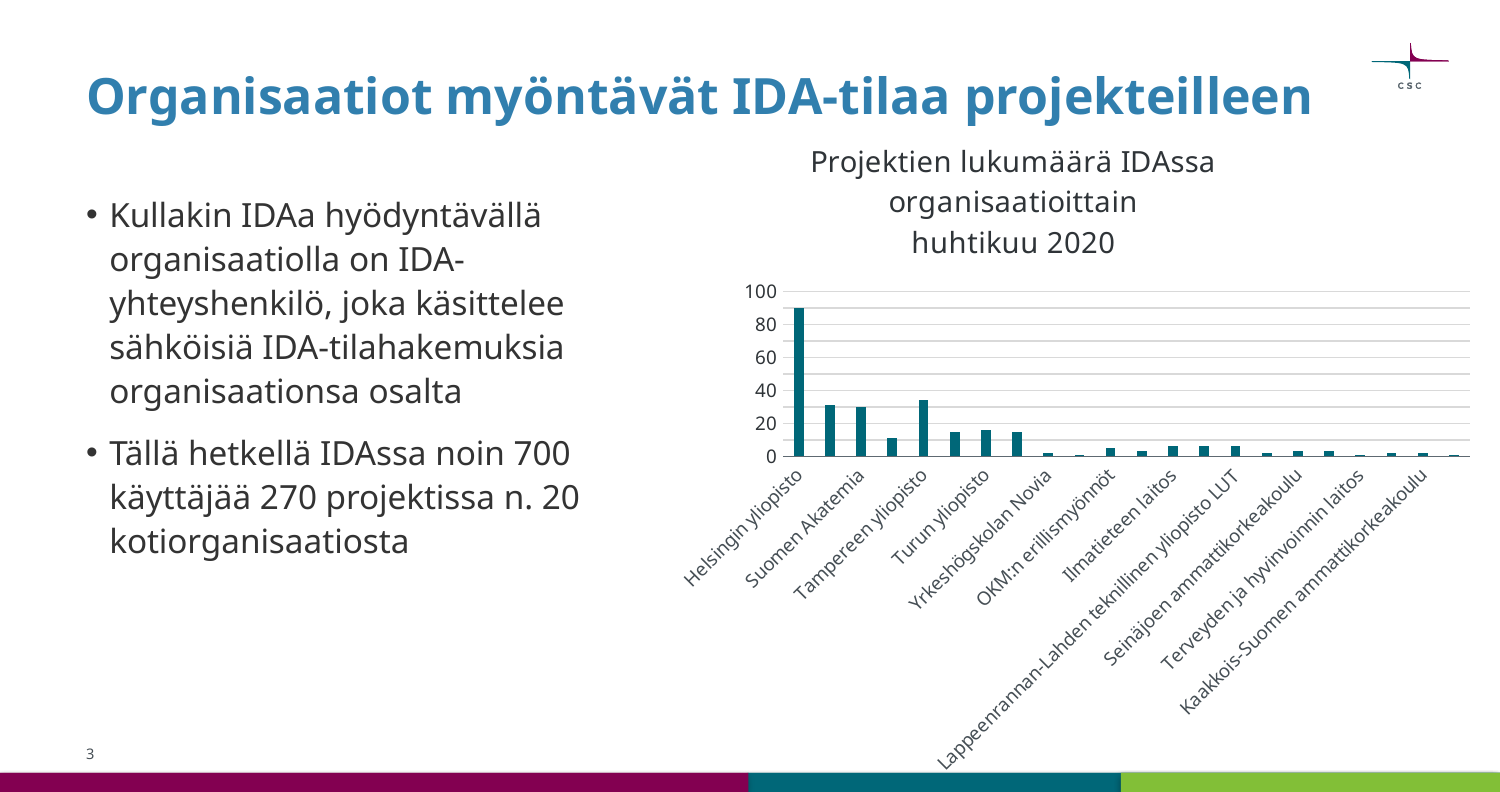
Which organisation has the highest number of projects in the chart? Helsingin yliopisto Is the value for Turun yliopisto greater or less than 20? less Is the value for Suomen Akatemia greater or less than 20? greater Which has more projects, Helsingin yliopisto or Suomen Akatemia? Helsingin yliopisto Which has more projects, Tampereen yliopisto or Turun yliopisto? Tampereen yliopisto Is the value for Tampereen yliopisto greater or less than 40? less What kind of chart is shown on the slide? bar chart What is the title of the chart? Projektien lukumäärä IDAssa organisaatioittain huhtikuu 2020 Do the values generally rise or fall from left to right along the x axis? fall